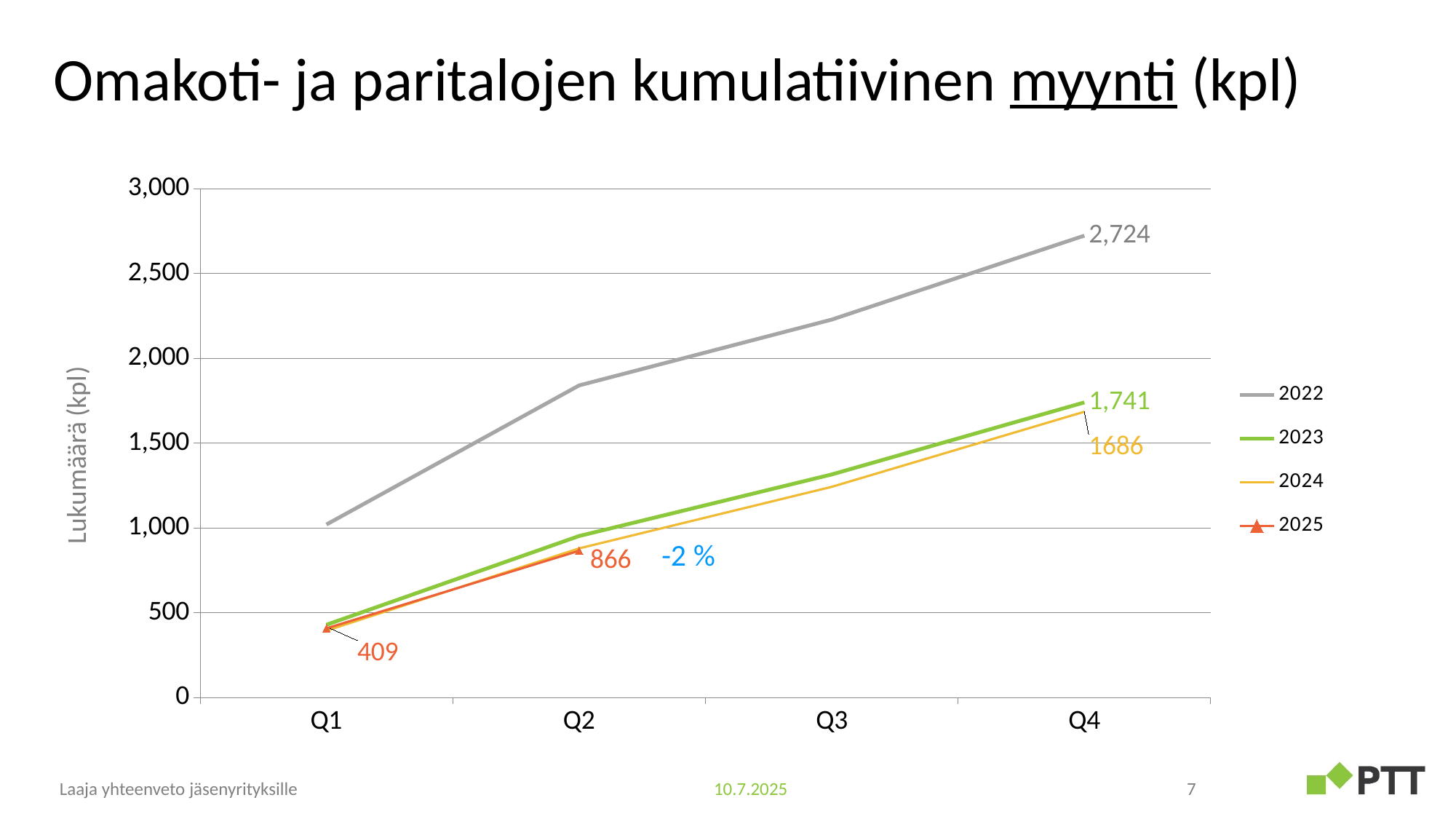
How many quarters are shown on the x axis? 4 Do the values for 2022 rise or fall from Q1 to Q4? rise What is the difference between the 2022 and 2023 values at Q4? 983 What is the value for 2022 at Q4? 2,724 What type of chart is shown on the slide? line chart What is the value for 2024 at Q4? 1686 What is the value for 2025 at Q1? 409 Is the value for 2022 at Q2 greater or less than 2,000? less What is the value for 2023 at Q4? 1,741 Which series has the highest value at Q4? 2022 How many series does the legend list? 4 What is the value for 2025 at Q2? 866